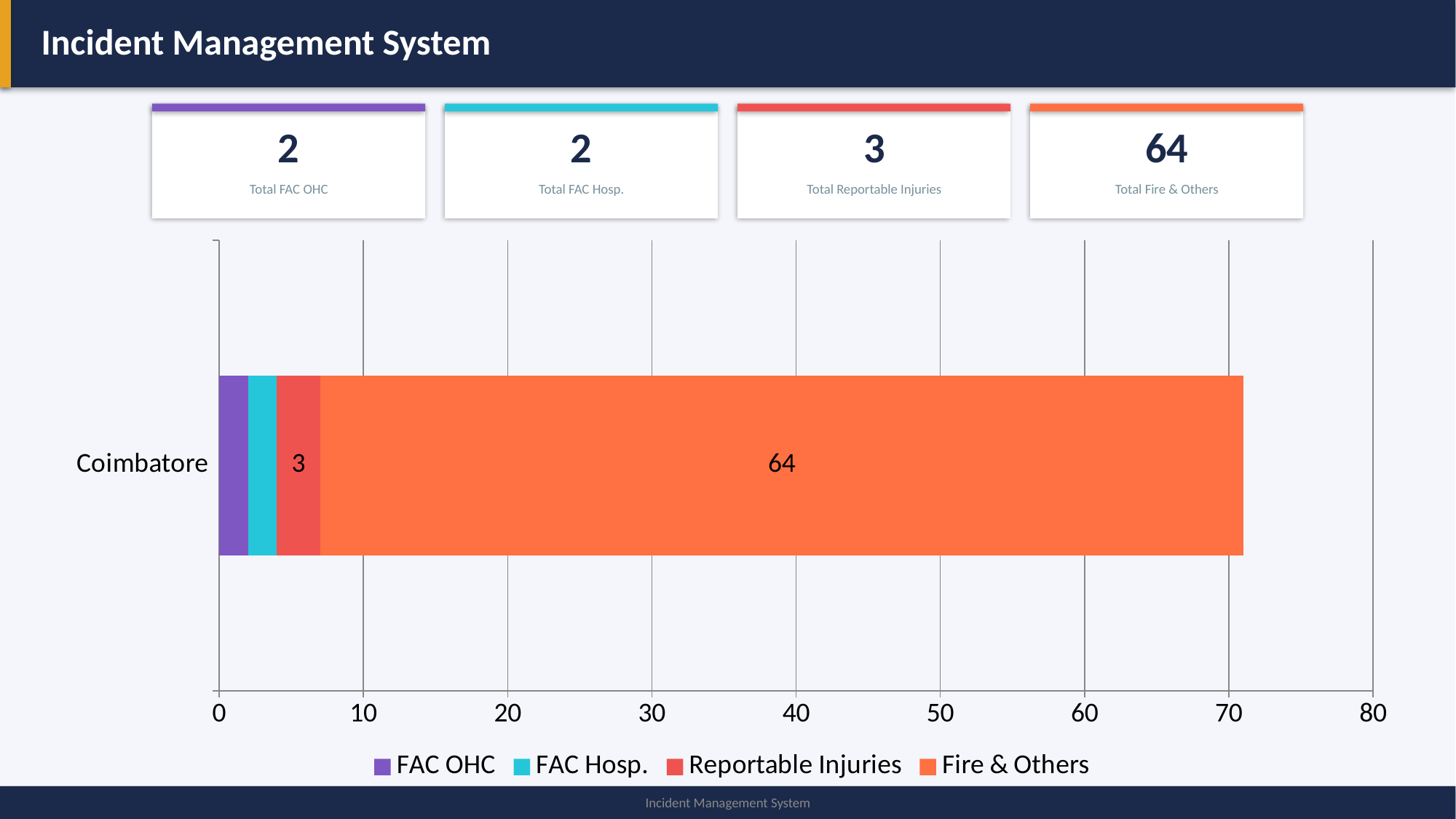
What is the value of Fire & Others for Coimbatore? 64 What is the value of Reportable Injuries for Coimbatore? 3 Is the value for Fire & Others greater or less than 60? greater Is the total length of the Coimbatore stacked bar greater or less than 80? less What is the difference between the Fire & Others value and the Reportable Injuries value for Coimbatore? 61 How many categories are shown on the chart's vertical axis? 1 Which series has the largest segment in the Coimbatore bar? Fire & Others How many series does the legend list? 4 Which is larger for Coimbatore, Fire & Others or Reportable Injuries? Fire & Others What colour represents Fire & Others in the legend? orange What kind of chart is shown on the slide? stacked bar chart Is the value for Reportable Injuries greater or less than 10? less